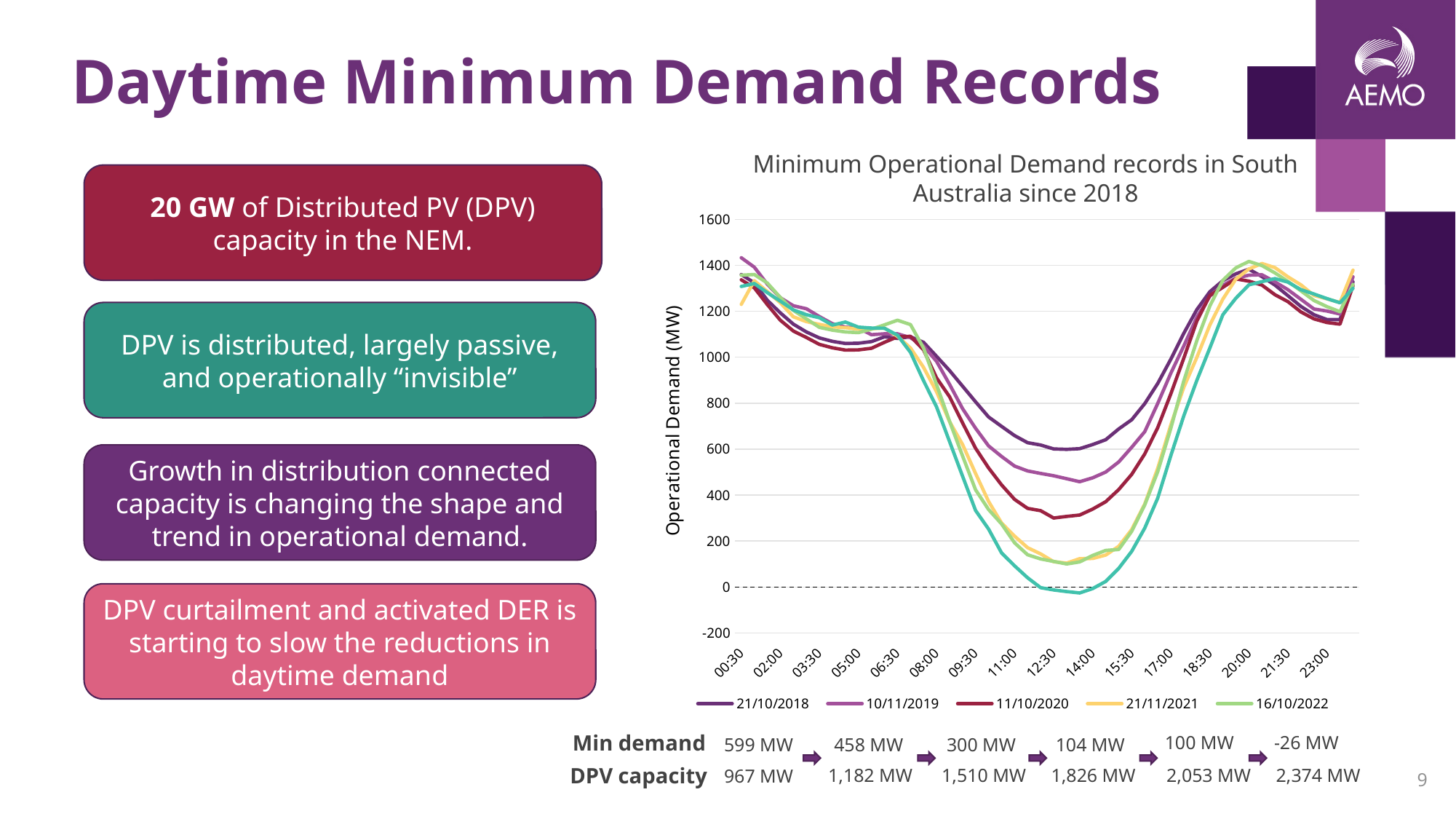
What kind of chart is shown on the slide? line chart Using the Min demand row below the chart, what is the difference between the 599 MW and 300 MW minimum demand values? 299 MW Is the value for 21/10/2018 at 12:30 greater or less than 400? greater At 12:30, which series has the higher value: 21/10/2018 or 11/10/2020? 21/10/2018 What is the title of the chart? Minimum Operational Demand records in South Australia since 2018 Is the value for 10/11/2019 at 14:00 greater or less than 600? less According to the Min demand row below the chart, what was the minimum demand for 21/10/2018? 599 MW Which legend series has the highest value around midday (12:30)? 21/10/2018 Is the value for 11/10/2020 at 12:30 greater or less than 400? less How many series does the chart legend list? 5 What is the label on the chart's vertical axis? Operational Demand (MW) Do the values rise or fall along the x axis between 00:30 and 12:30? fall